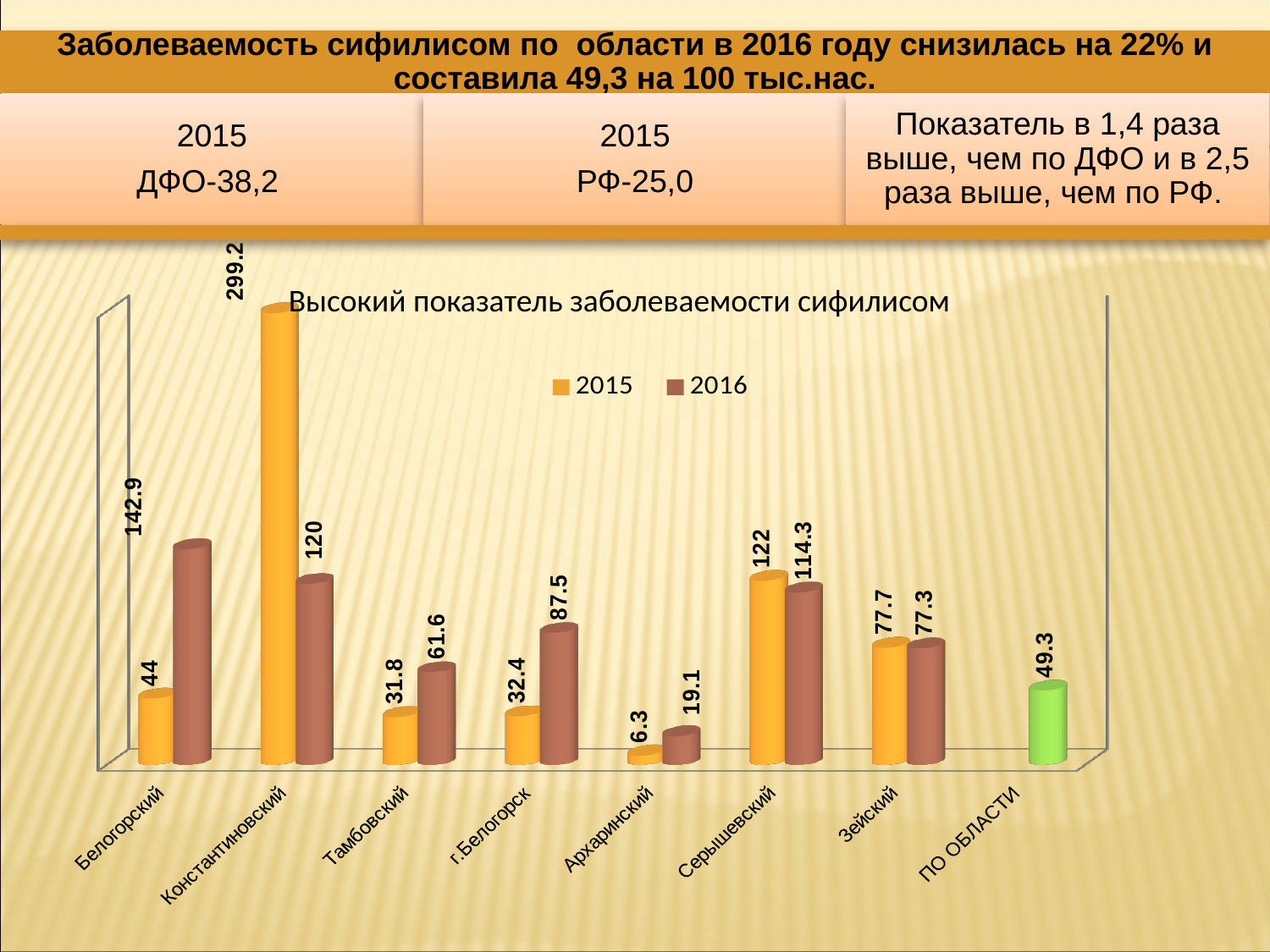
How many series does the legend list? 2 By how much did the value for Тамбовский increase from 2015 to 2016? 29.8 For Белогорский, which year has the larger value, 2015 or 2016? 2016 Which category has the highest 2015 value? Константиновский How many categories are shown on the x axis? 8 Which category has the lowest 2016 value? Архаринский What is the value shown for ПО ОБЛАСТИ? 49.3 What is the 2016 value for Белогорский? 142.9 What is the 2015 value for Константиновский? 299.2 What type of chart is shown on the slide? Bar chart What is the difference between the 2015 and 2016 values for Серышевский? 7.7 What is the 2016 value for г.Белогорск? 87.5